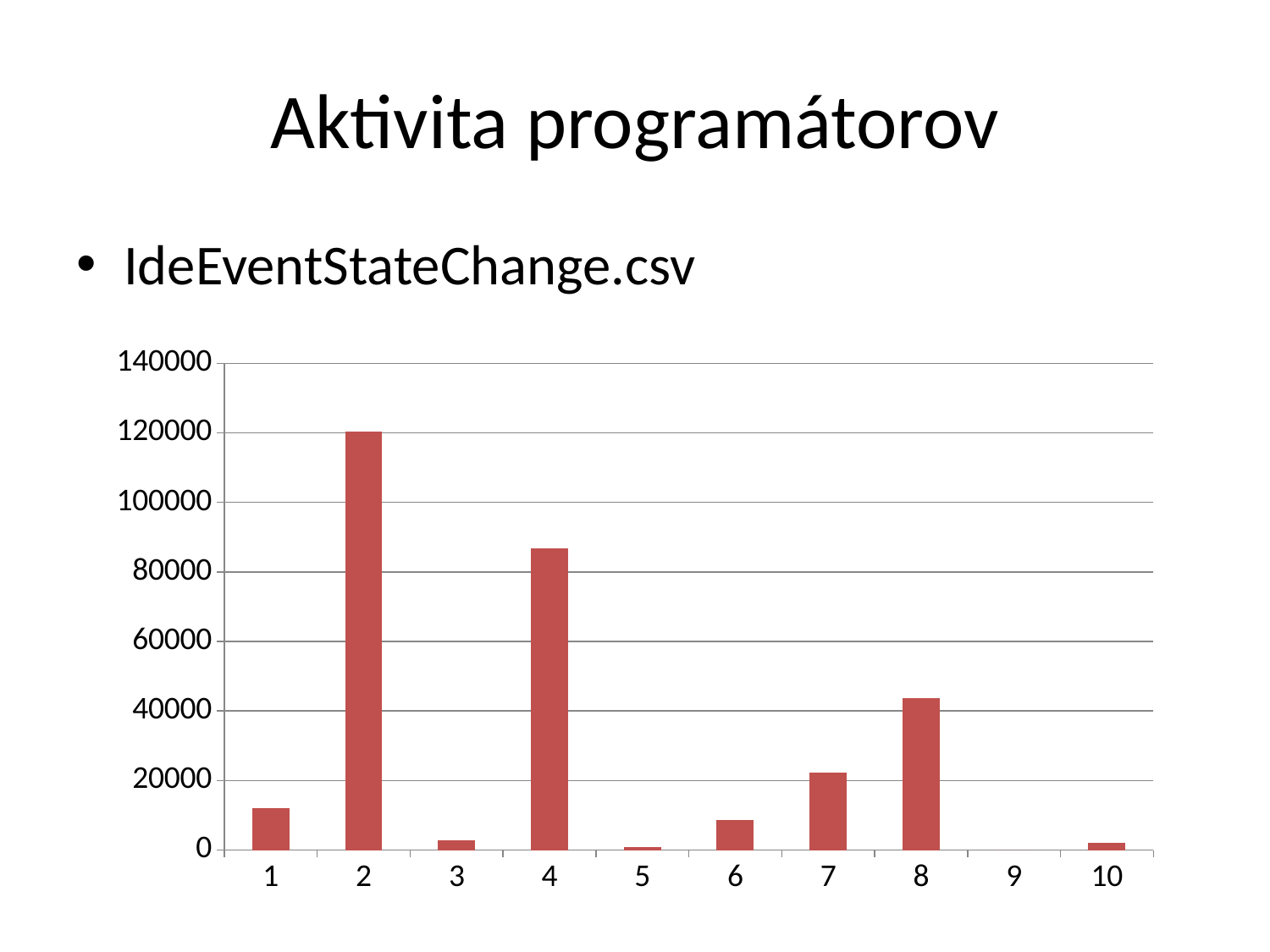
Which is larger, the value for category 7 or the value for category 1? 7 Which is larger, the value for category 4 or the value for category 8? 4 What is the title of the slide containing the chart? Aktivita programátorov Is the value for category 8 greater or less than 40000? greater Is the value for category 1 greater or less than 20000? less How many categories are shown on the x axis of the chart? 10 Is the value for category 4 greater or less than 80000? greater Which category has the highest bar in the chart? 2 Which category has the lowest bar in the chart? 9 What kind of chart is shown on the slide? bar chart